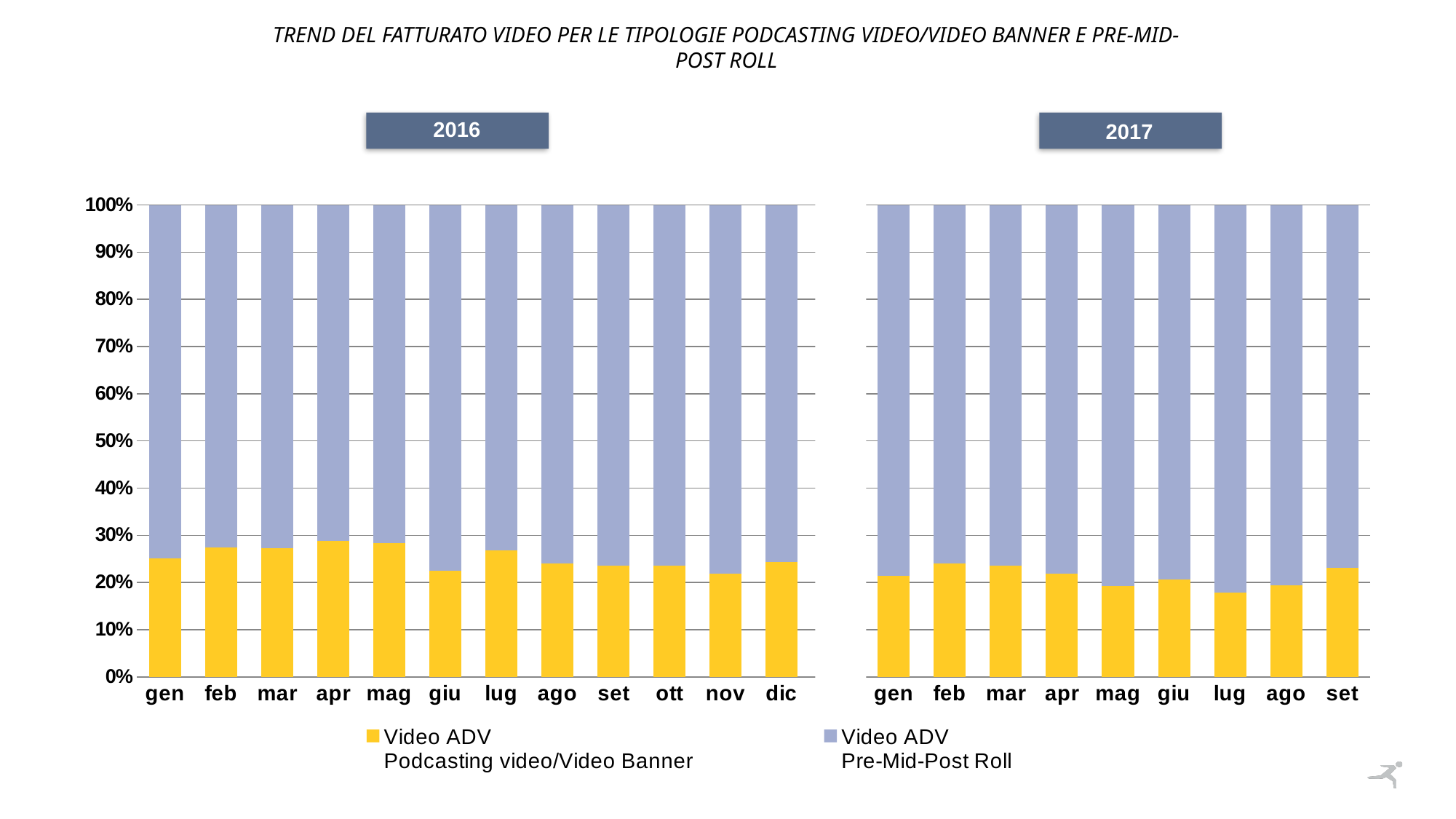
In the 2017 chart, which month has the lowest Video ADV Podcasting video/Video Banner share? lug How many series does the legend list? 2 In the 2016 chart, is the Video ADV Podcasting video/Video Banner share for apr greater or less than 20%? greater What kind of chart is used for the 2016 data? Stacked bar chart How many months are shown on the x axis of the 2016 chart? 12 In the 2017 chart, is the Video ADV Podcasting video/Video Banner share for lug greater or less than 20%? less How many months are shown on the x axis of the 2017 chart? 9 In the 2017 chart, is the Video ADV Pre-Mid-Post Roll share for lug greater or less than 80%? greater In the 2017 chart, which is larger, the Video ADV Podcasting video/Video Banner share for feb or for lug? feb Which colour represents Video ADV Pre-Mid-Post Roll in the legend? Blue-grey In the 2016 chart, which is larger, the Video ADV Podcasting video/Video Banner share for apr or for giu? apr